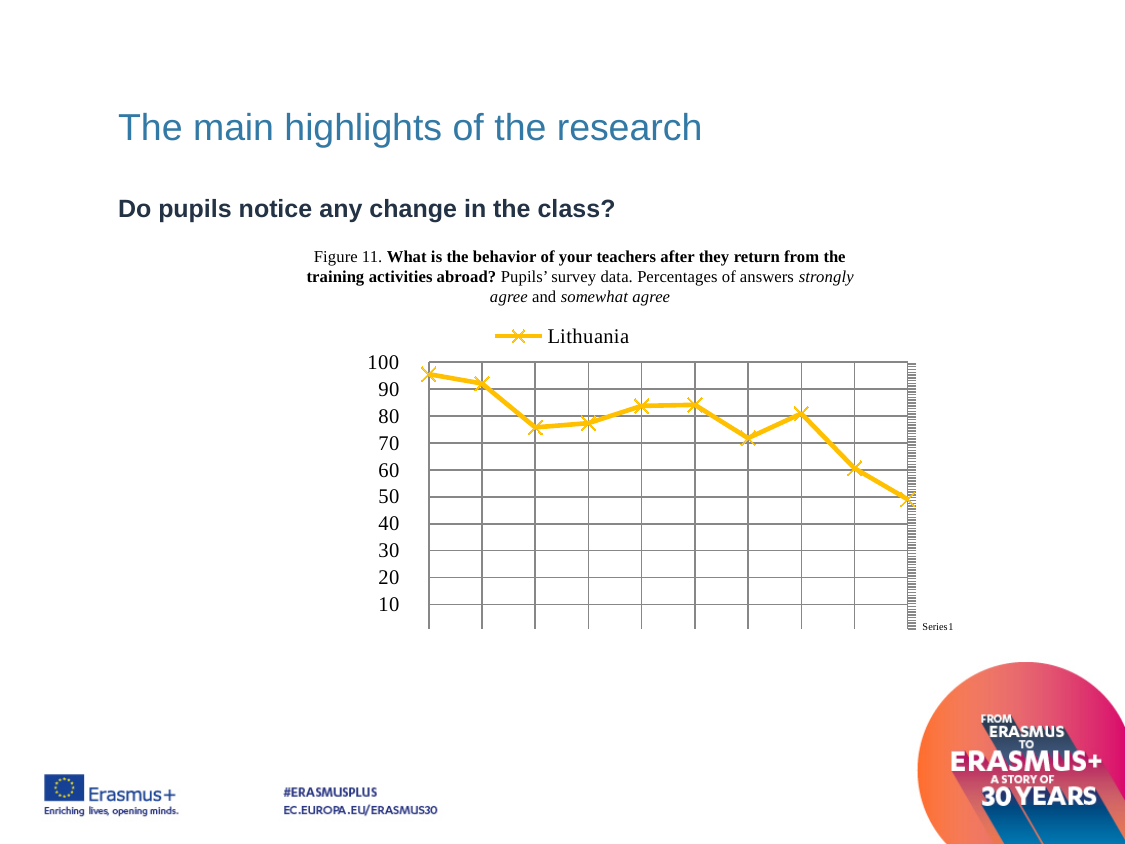
How many series does the chart's legend list? 1 Is the value of the ninth point from the left on the Lithuania line greater or less than 70? less What is the name of the series shown in the chart's legend? Lithuania Overall, do the values of the Lithuania line rise or fall from left to right along the x axis? fall Which point on the Lithuania line has the lowest value? the last (rightmost) point How many data points are plotted on the Lithuania line? 10 Is the value of the third point from the left on the Lithuania line greater or less than 80? less What kind of chart is shown on the slide? line chart Which point on the Lithuania line has the highest value, the first or the last? the first Is the value of the first (leftmost) point on the Lithuania line greater or less than 90? greater What is the highest value shown on the chart's vertical axis? 100